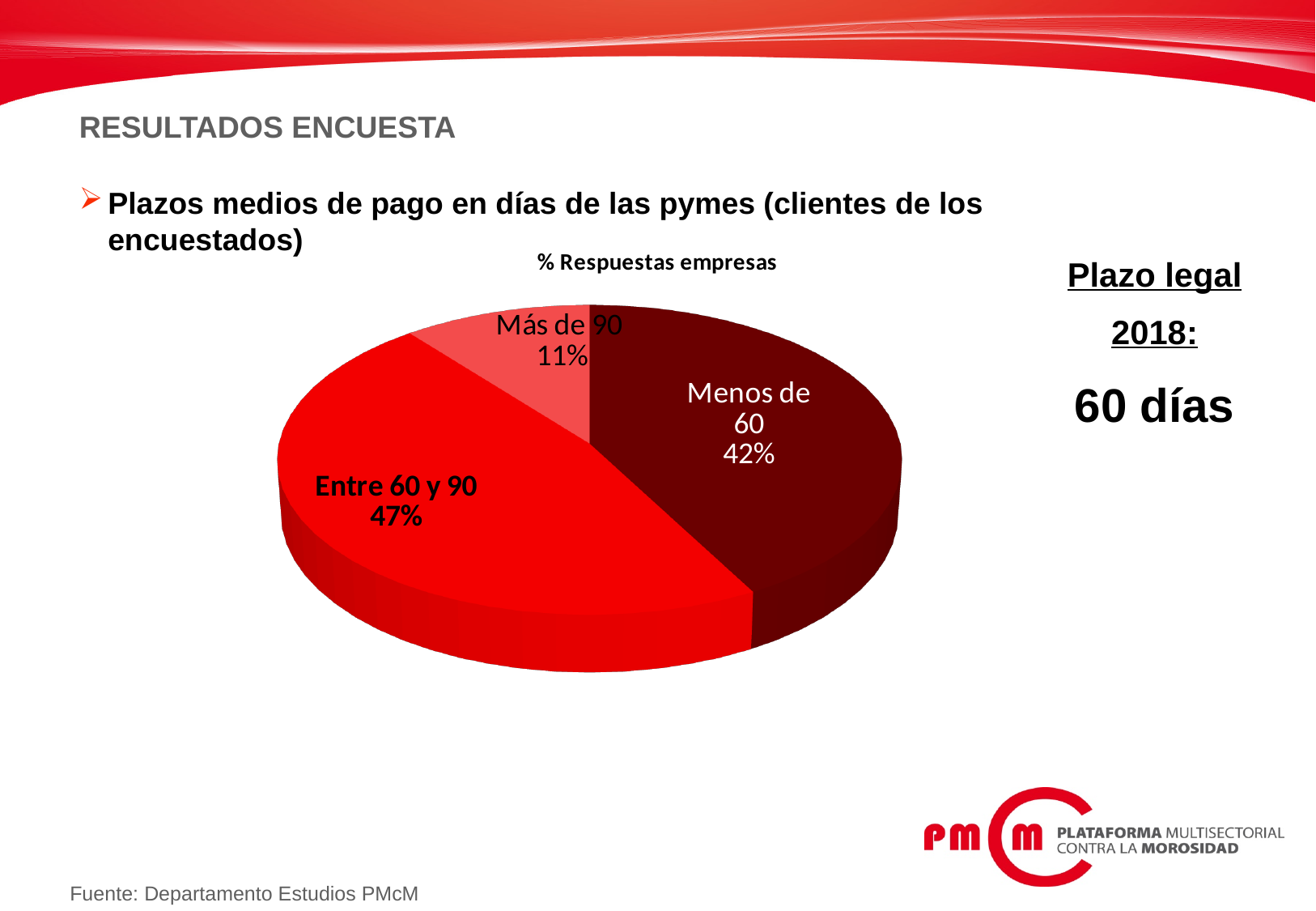
What percentage of responses fall in the 'Entre 60 y 90' category? 47% Which category has the largest share of responses? Entre 60 y 90 What percentage of responses fall in the 'Menos de 60' category? 42% Which is larger, the share for 'Menos de 60' or the share for 'Más de 90'? Menos de 60 What is the title of the chart? % Respuestas empresas Which category has the smallest share of responses? Más de 90 What is the combined share of 'Entre 60 y 90' and 'Más de 90'? 58% What kind of chart is shown on the slide? Pie chart How many categories does the pie chart show? 3 What is the difference in percentage points between 'Entre 60 y 90' and 'Menos de 60'? 5 What is the difference in percentage points between 'Entre 60 y 90' and 'Más de 90'? 36 What percentage of responses fall in the 'Más de 90' category? 11%